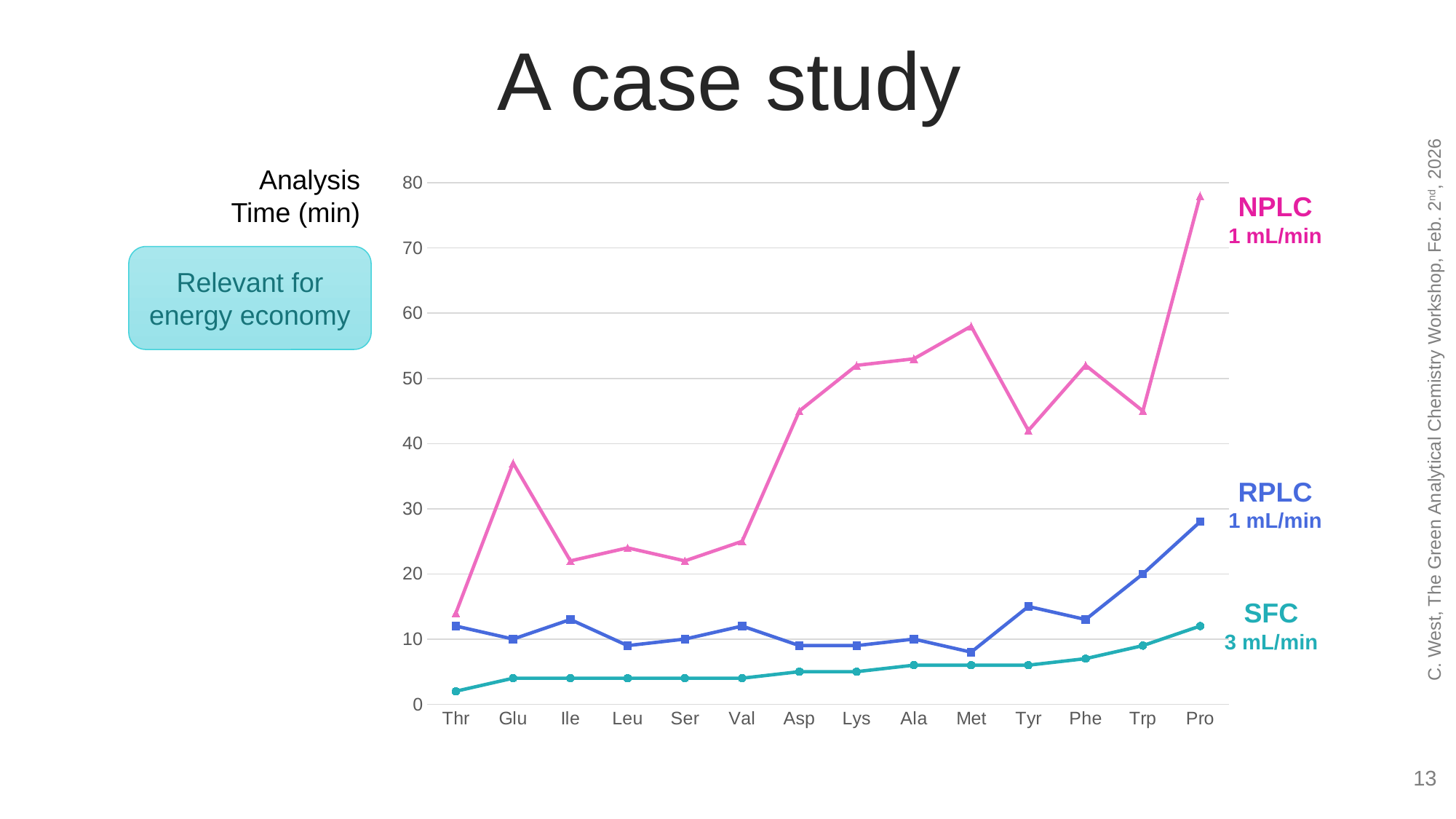
Is the RPLC analysis time for Met greater or less than 10? less What kind of chart is shown on the slide? line chart For which amino acid is the NPLC analysis time highest? Pro Is the NPLC analysis time for Pro greater or less than 70? greater What is the RPLC analysis time for Trp? 20 Is the NPLC analysis time for Glu greater or less than 30? greater For which amino acid is the SFC analysis time lowest? Thr Which has the larger analysis time for Met, NPLC or SFC? NPLC How many amino acid categories are shown on the x axis? 14 For which amino acid is the NPLC analysis time lowest? Thr How many series are plotted on the chart? 3 What flow rate is given for the SFC series? 3 mL/min